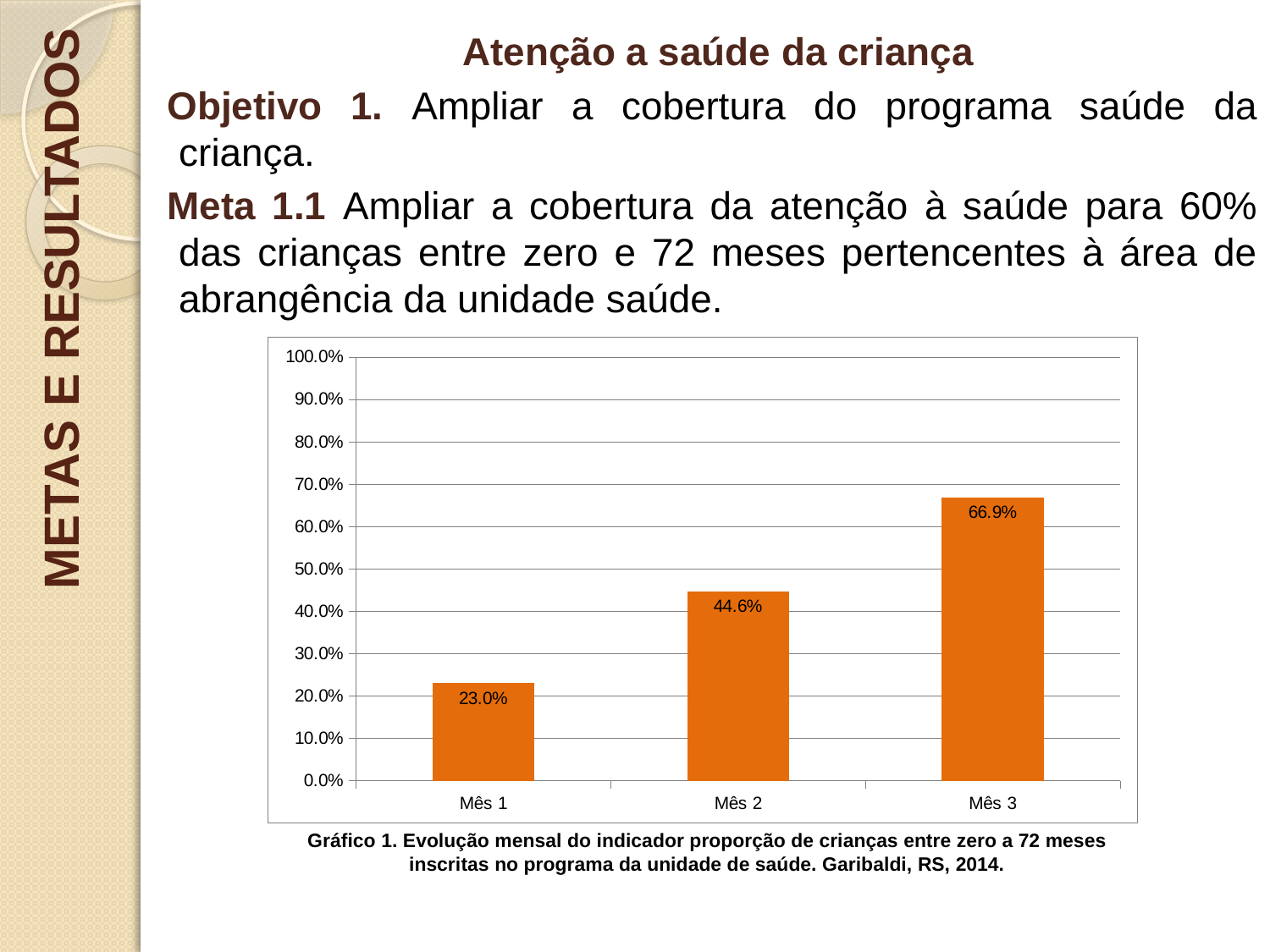
What is the value for Mês 2? 44.6% What is the value for Mês 3? 66.9% Do the values rise or fall from Mês 1 to Mês 3? rise What is the difference between the values for Mês 3 and Mês 1? 43.9% Which is larger, the value for Mês 2 or the value for Mês 3? Mês 3 Which month has the highest value? Mês 3 How many months are shown on the x axis? 3 Which month has the lowest value? Mês 1 What kind of chart is shown on the slide? bar chart What is the difference between the values for Mês 2 and Mês 1? 21.6% What is the value for Mês 1? 23.0% Is the value for Mês 3 greater or less than 60.0%? greater